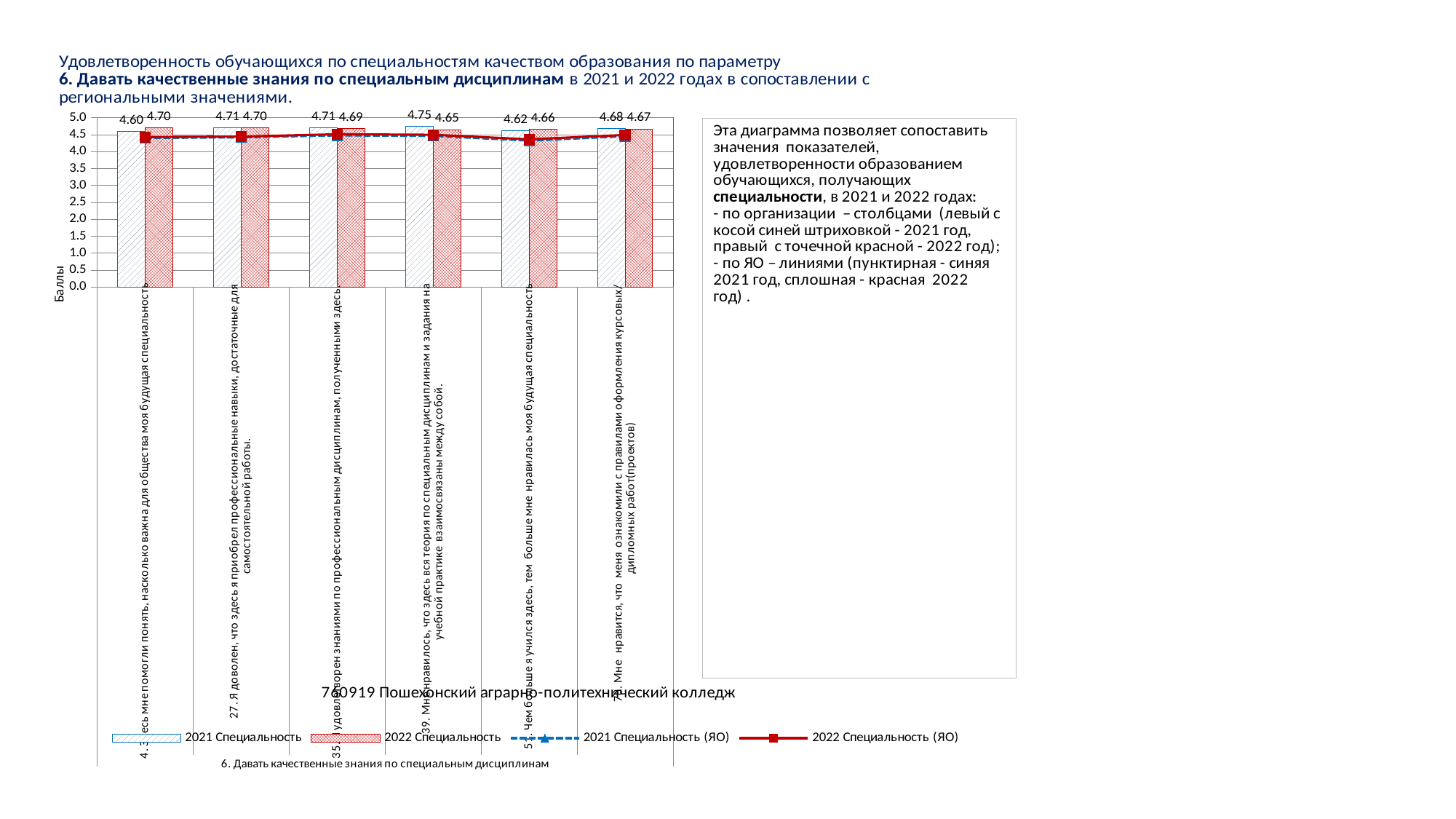
What kind of chart is shown on the slide? Combination bar and line chart For the leftmost category, what is the difference between the 2022 value (4.70) and the 2021 value (4.60)? 0.10 What is the difference between the 2021 and 2022 Специальность values for category 39 (теория и задания на учебной практике взаимосвязаны)? 0.10 Which category has the lowest 2022 Специальность value? 39. Мне нравилось, что здесь вся теория по специальным дисциплинам и задания на учебной практике взаимосвязаны между собой (4.65) Is the 2022 Специальность value for the rightmost category greater or less than 4.0? greater What is the 2022 Специальность value for the category "39. Мне нравилось, что здесь вся теория по специальным дисциплинам и задания на учебной практике взаимосвязаны между собой"? 4.65 What is the 2021 Специальность value for the category "27. Я доволен, что здесь я приобрел профессиональные навыки, достаточные для самостоятельной работы"? 4.71 What is the 2022 Специальность value for the category "Мне нравится, что меня ознакомили с правилами оформления курсовых работ(проектов)/дипломных работ"? 4.67 Which category has the highest 2021 Специальность value? 39. Мне нравилось, что здесь вся теория по специальным дисциплинам и задания на учебной практике взаимосвязаны между собой (4.75) For category 27 (приобрел профессиональные навыки), which is larger: the 2021 Специальность value or the 2022 Специальность value? 2021 Специальность (4.71) How many series does the chart legend list? 4 How many categories are shown on the x axis of the chart? 6